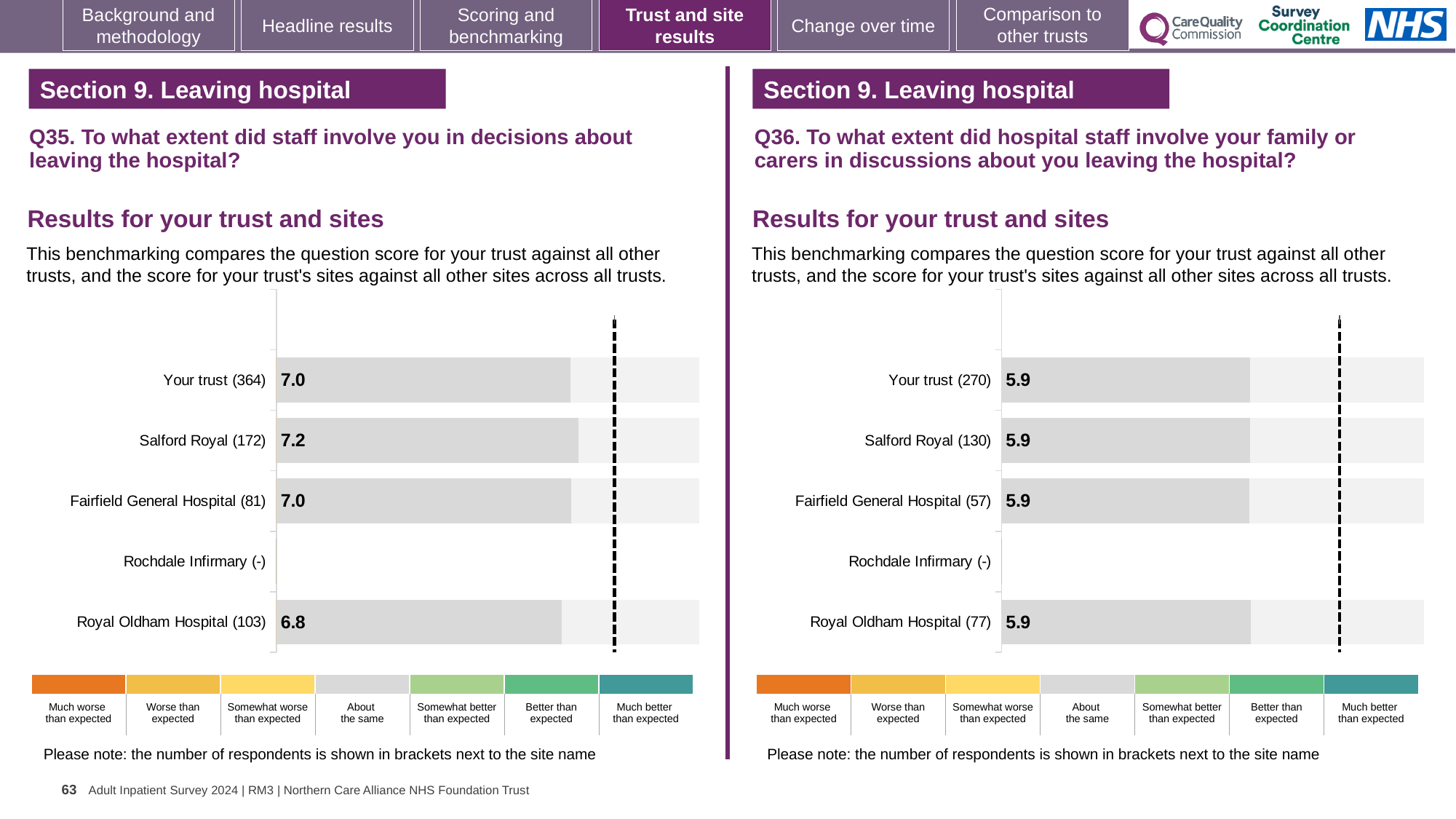
In the Q35 chart on the left, which site has no score bar shown? Rochdale Infirmary In the Q35 chart on the left, which site with a plotted score has the lowest score? Royal Oldham Hospital In the Q35 chart on the left, which site has the highest score? Salford Royal In the Q35 chart on the left, what is the score for Salford Royal? 7.2 In the Q35 chart on the left, what is the score for Royal Oldham Hospital? 6.8 In the Q36 chart on the right, what is the score for Your trust? 5.9 What kind of chart is the Q35 chart on the left? Bar chart In the Q36 chart on the right, how many bars have a score printed? 4 How many sites (including Your trust) are listed on the y axis of the Q35 chart on the left? 5 In the Q35 chart on the left, which has the higher score: Your trust or Royal Oldham Hospital? Your trust In the Q36 chart on the right, what is the score for Fairfield General Hospital? 5.9 In the Q35 chart on the left, what is the difference between the scores for Salford Royal and Royal Oldham Hospital? 0.4